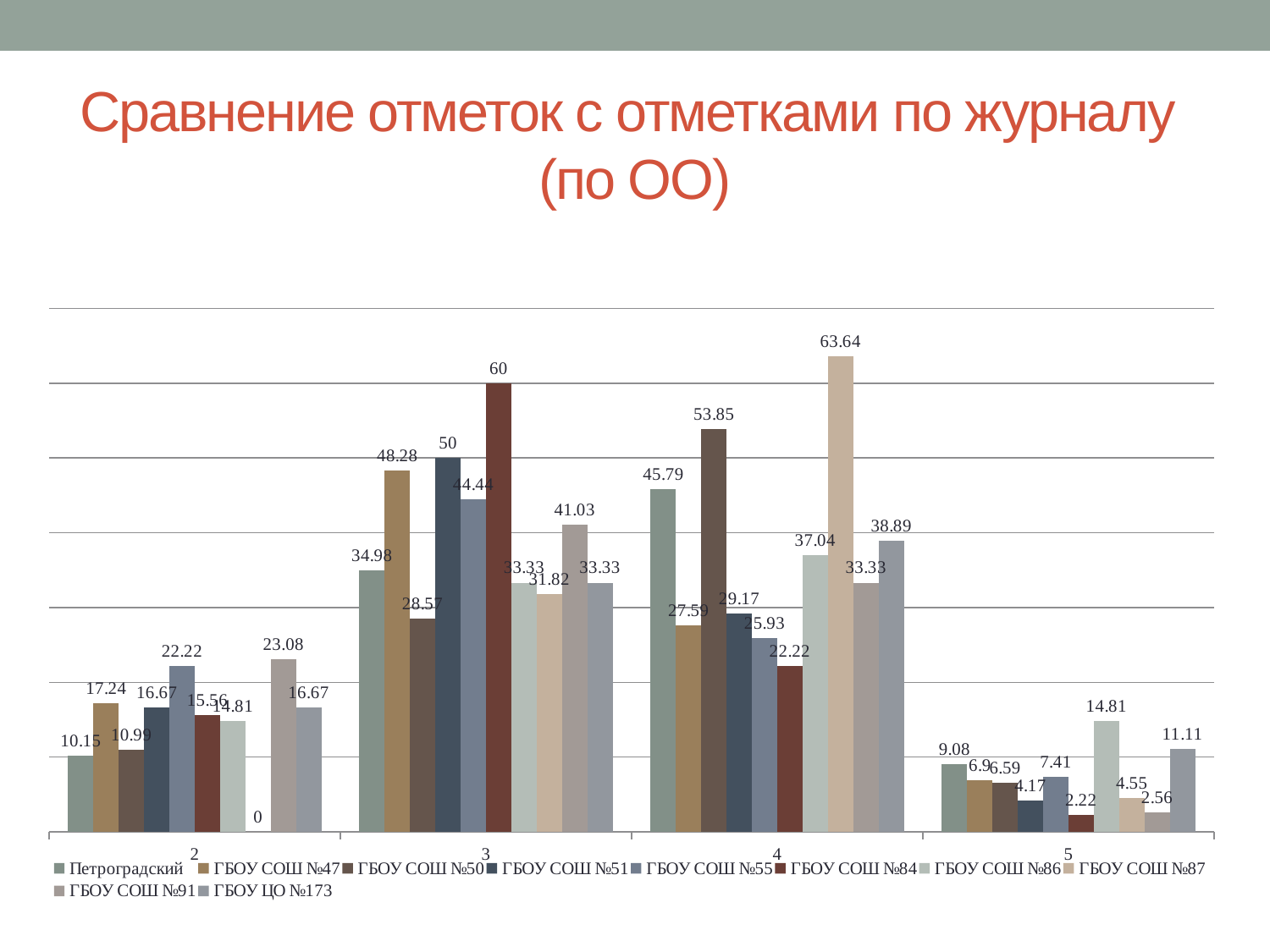
Which series has the highest value at category 3? ГБОУ СОШ №84 What is the value for ГБОУ СОШ №91 at category 2? 23.08 What is the value for ГБОУ СОШ №87 at category 4? 63.64 Which series has the lowest value at category 2? ГБОУ СОШ №87 At category 4, which is larger: the value for ГБОУ СОШ №50 or the value for ГБОУ СОШ №47? ГБОУ СОШ №50 What is the difference between the value for ГБОУ СОШ №84 and the value for Петроградский at category 3? 25.02 How many categories are shown on the x axis? 4 What kind of chart is shown on the slide? bar chart How many series does the legend list? 10 What is the value for Петроградский at category 3? 34.98 What is the value for ГБОУ ЦО №173 at category 5? 11.11 Which series has the highest value at category 5? ГБОУ СОШ №86